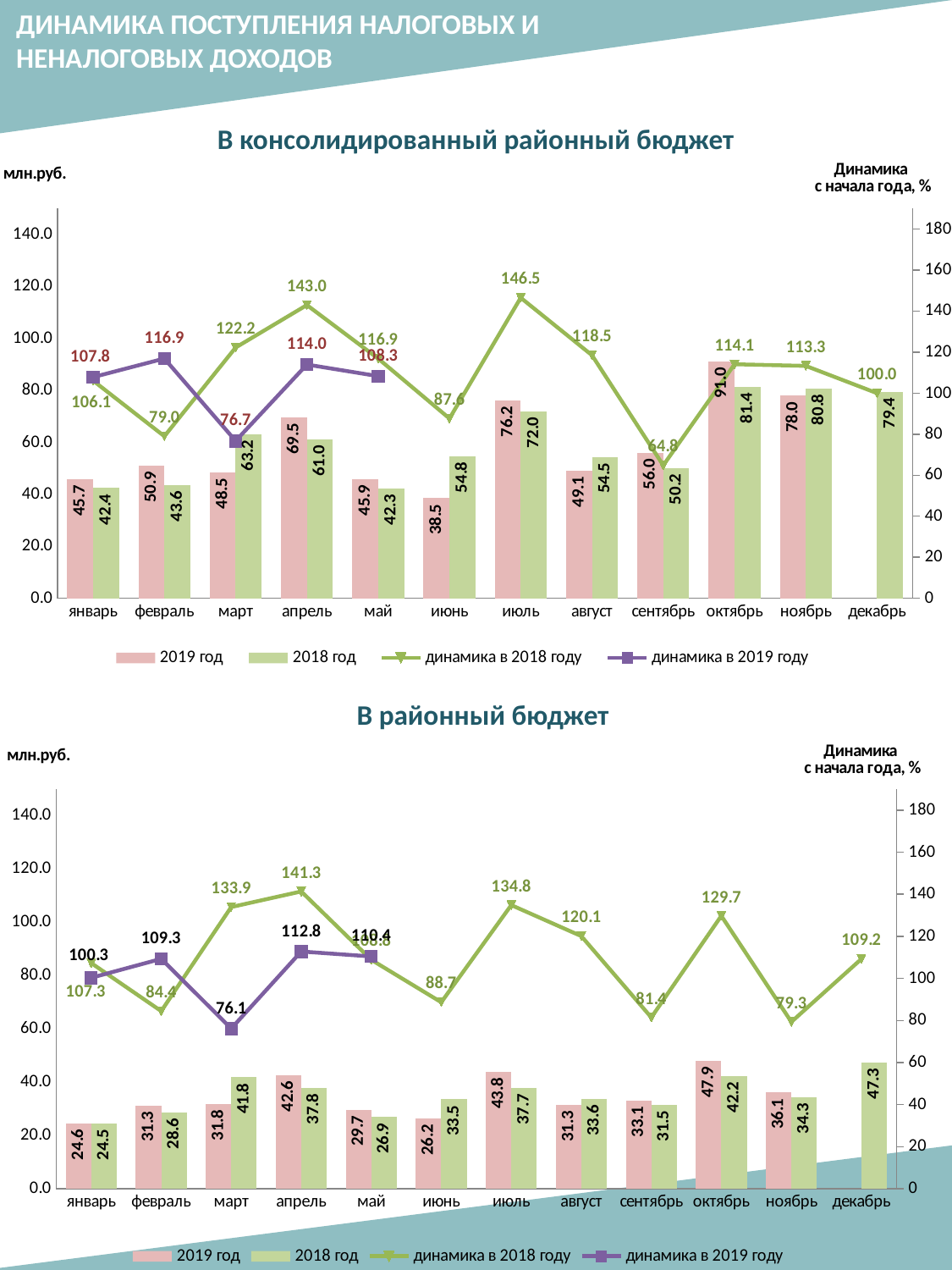
In the chart 'В районный бюджет', which is larger for март: the 2019 год value or the 2018 год value? 2018 год In the chart 'В районный бюджет', what is the 'динамика в 2019 году' value for март? 76.1 In the chart 'В консолидированный районный бюджет', what is the difference between the 2019 год and 2018 год values for апрель? 8.5 In the chart 'В консолидированный районный бюджет', which month has the lowest 'динамика в 2018 году' value? сентябрь In the chart 'В консолидированный районный бюджет', what is the 2019 год value for октябрь? 91.0 In the chart 'В консолидированный районный бюджет', what is the 2018 год value for декабрь? 79.4 In the chart 'В районный бюджет', how many months are shown on the x axis? 12 In the chart 'В консолидированный районный бюджет', what is the 'динамика в 2018 году' value for июль? 146.5 In the chart 'В районный бюджет', which month has the highest 'динамика в 2018 году' value? апрель In the chart 'В консолидированный районный бюджет', which month has the highest 2019 год value? октябрь In the chart 'В районный бюджет', what is the 2019 год value for июль? 43.8 In the chart 'В консолидированный районный бюджет', how many series does the legend list? 4